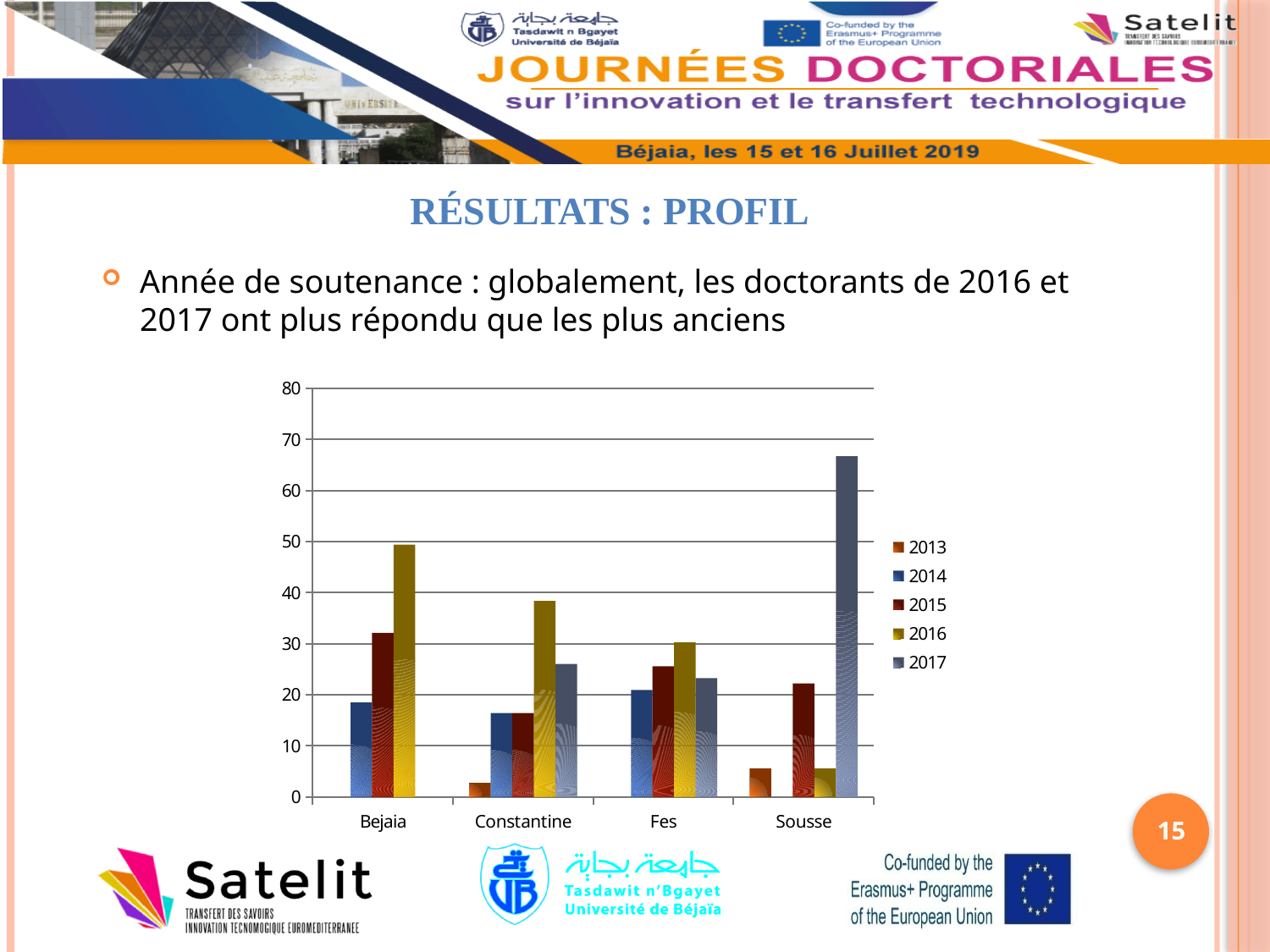
Which series has the tallest bar for Bejaia? 2016 What kind of chart is shown on the slide? bar chart Is the value for 2016 in Bejaia greater or less than 40? greater How many categories are shown on the x axis of the chart? 4 How many series does the chart's legend list? 5 Which years are listed in the chart's legend? 2013, 2014, 2015, 2016, 2017 Which series has the tallest bar for Sousse? 2017 Which is larger, the 2016 bar for Constantine or the 2016 bar for Fes? Constantine Is the value for 2013 in Constantine greater or less than 10? less Which category has the tallest bar in the chart? Sousse Is the value for 2017 in Sousse greater or less than 60? greater Which is larger, the 2015 bar for Bejaia or the 2015 bar for Sousse? Bejaia